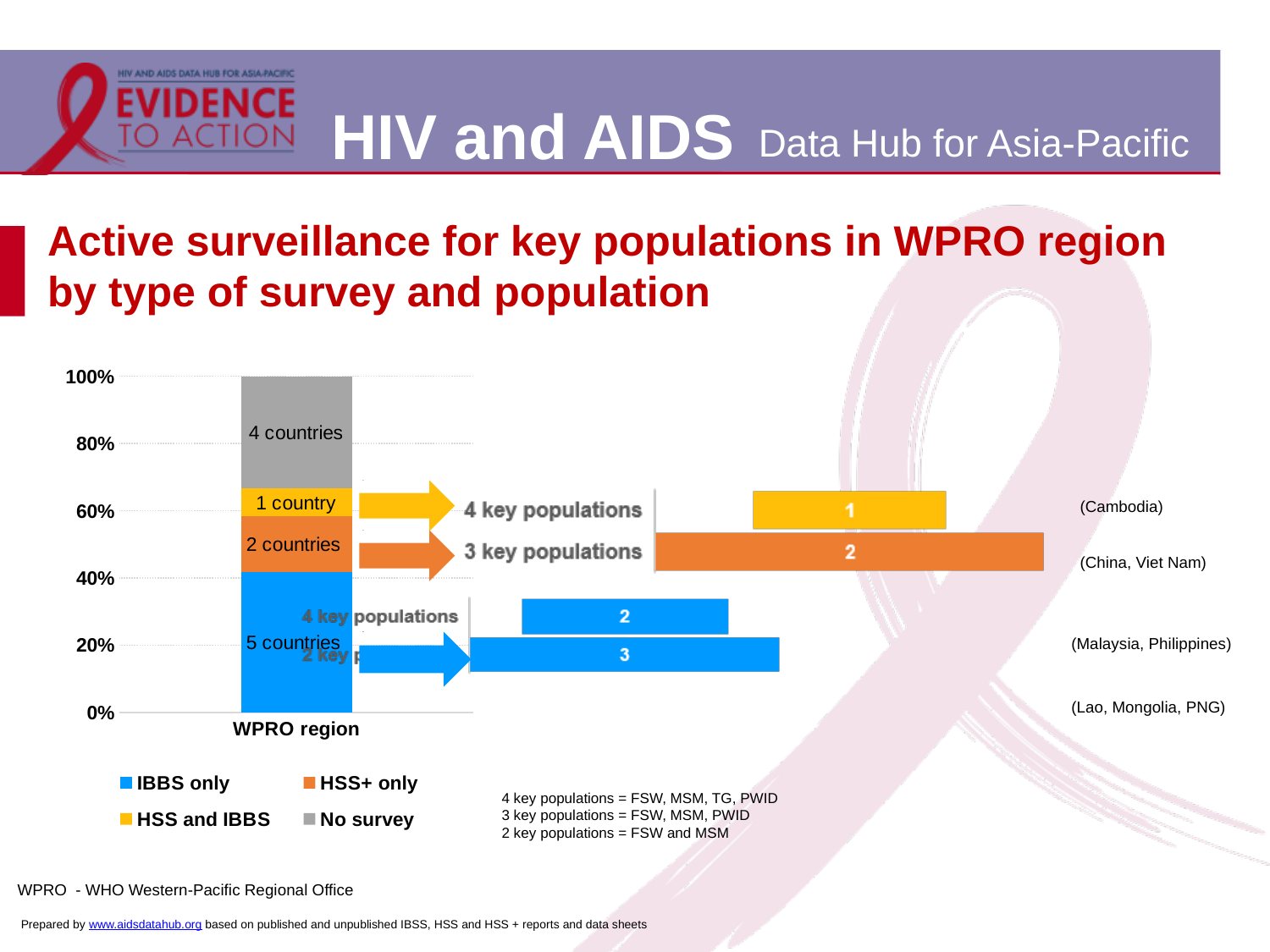
Which survey type segment has the smallest number of countries? HSS and IBBS How many series does the legend list? 4 How many countries are in the 'HSS and IBBS' segment of the WPRO region bar? 1 country Which has more countries, 'HSS+ only' or 'HSS and IBBS'? HSS+ only How many categories are shown on the x axis of the chart? 1 How many more countries are in the 'IBBS only' segment than in the 'No survey' segment? 1 country What kind of chart is shown on the slide? Stacked bar chart How many countries are in the 'No survey' segment of the WPRO region bar? 4 countries What is the total number of countries across all segments of the WPRO region bar? 12 countries How many countries are in the 'HSS+ only' segment of the WPRO region bar? 2 countries How many countries are in the 'IBBS only' segment of the WPRO region bar? 5 countries Which survey type segment has the largest number of countries? IBBS only